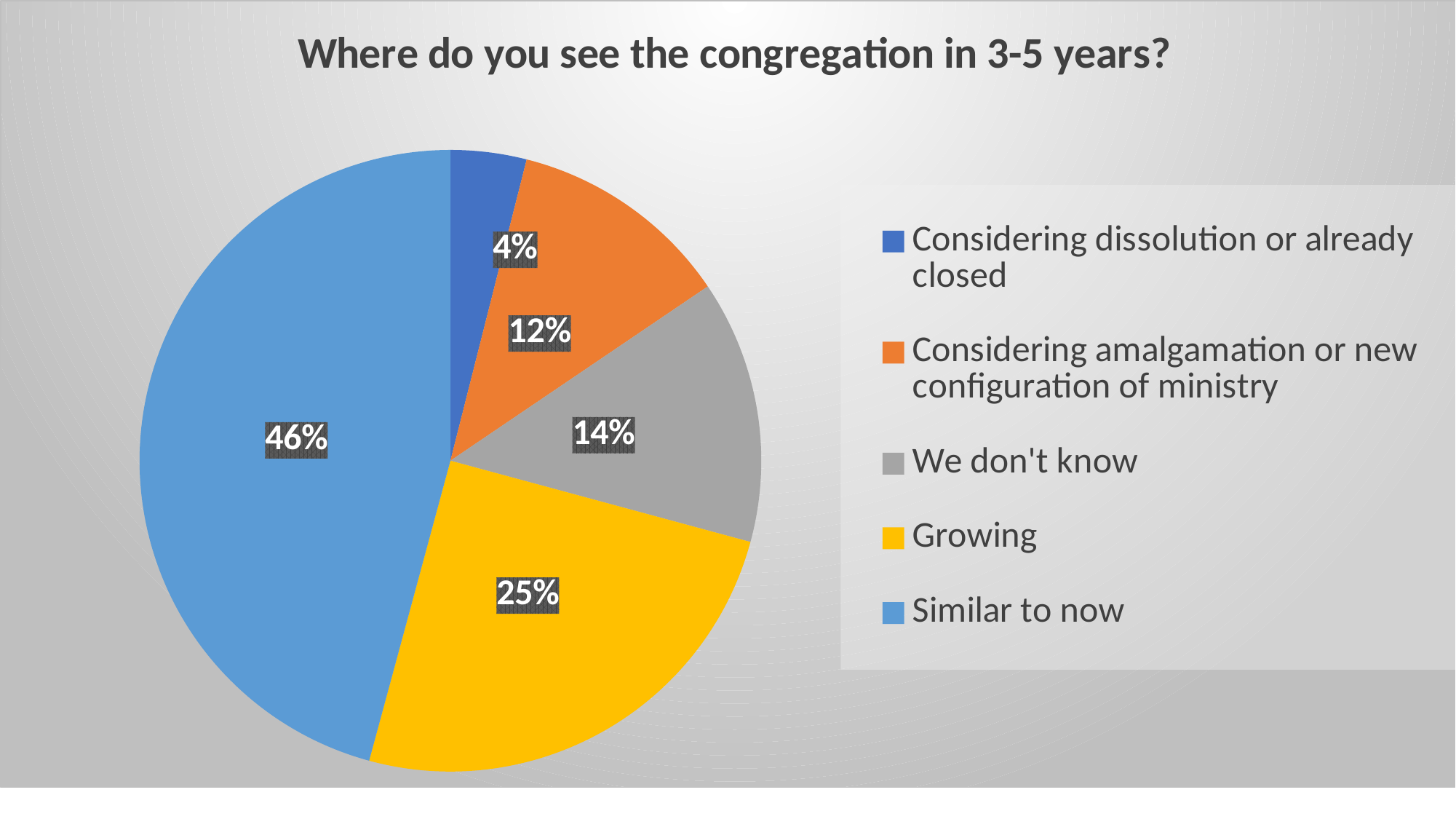
What percentage of respondents answered "Similar to now"? 46% What is the title of the chart? Where do you see the congregation in 3-5 years? How many categories does the pie chart show? 5 Which is larger, the share for "We don't know" or the share for "Considering amalgamation or new configuration of ministry"? We don't know Which response has the smallest share of the pie? Considering dissolution or already closed What is the difference in percentage points between "Similar to now" and "Growing"? 21 What percentage of respondents answered "Growing"? 25% What kind of chart is shown on the slide? pie chart Which response has the largest share of the pie? Similar to now What percentage of respondents answered "Considering amalgamation or new configuration of ministry"? 12% What percentage of respondents answered "Considering dissolution or already closed"? 4% What percentage of respondents answered "We don't know"? 14%